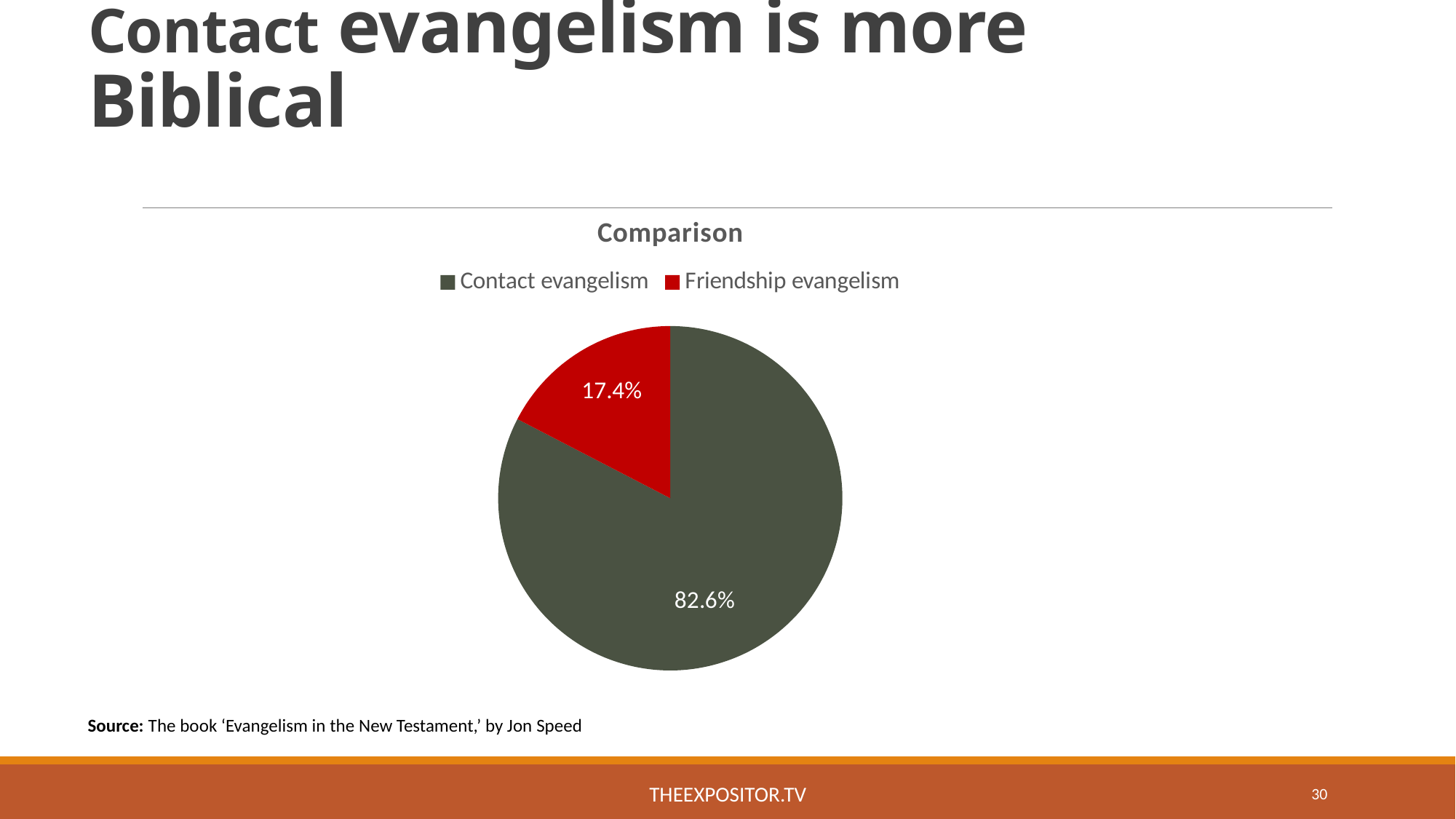
What share of the pie does Contact evangelism take? 82.6% What is the title of the chart? Comparison What is the difference in percentage points between the Contact evangelism and Friendship evangelism slices? 65.2 How many slices does the pie chart have? 2 What colour is the Friendship evangelism slice? red Which is larger, the Contact evangelism slice or the Friendship evangelism slice? Contact evangelism Which slice of the pie is the largest? Contact evangelism What kind of chart is shown on the slide? pie chart Which slice of the pie is the smallest? Friendship evangelism How many entries does the legend list? 2 What share of the pie does Friendship evangelism take? 17.4%